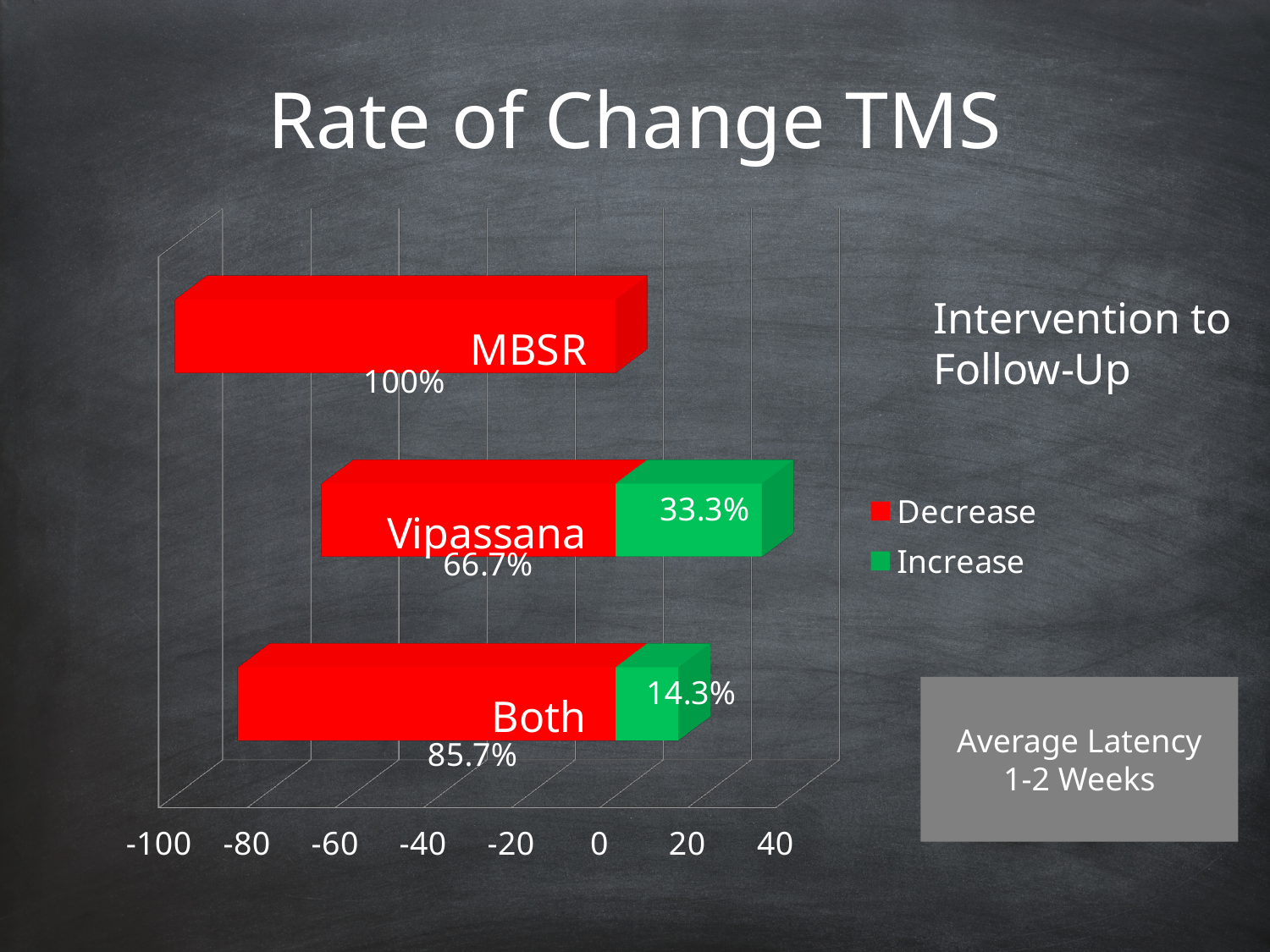
Which category has the highest Decrease value? MBSR How many categories are shown in the chart? 3 What is the Decrease value for Both? 85.7% How many series does the legend list? 2 Which has a larger Decrease value, Vipassana or Both? Both What kind of chart is shown on the slide? Bar chart What colour represents the Increase series in the legend? Green What is the Increase value for Both? 14.3% What is the difference between the Increase values for Vipassana and Both? 19% What is the Decrease value for MBSR? 100% Which category has the lowest Decrease value? Vipassana What is the Increase value for Vipassana? 33.3%